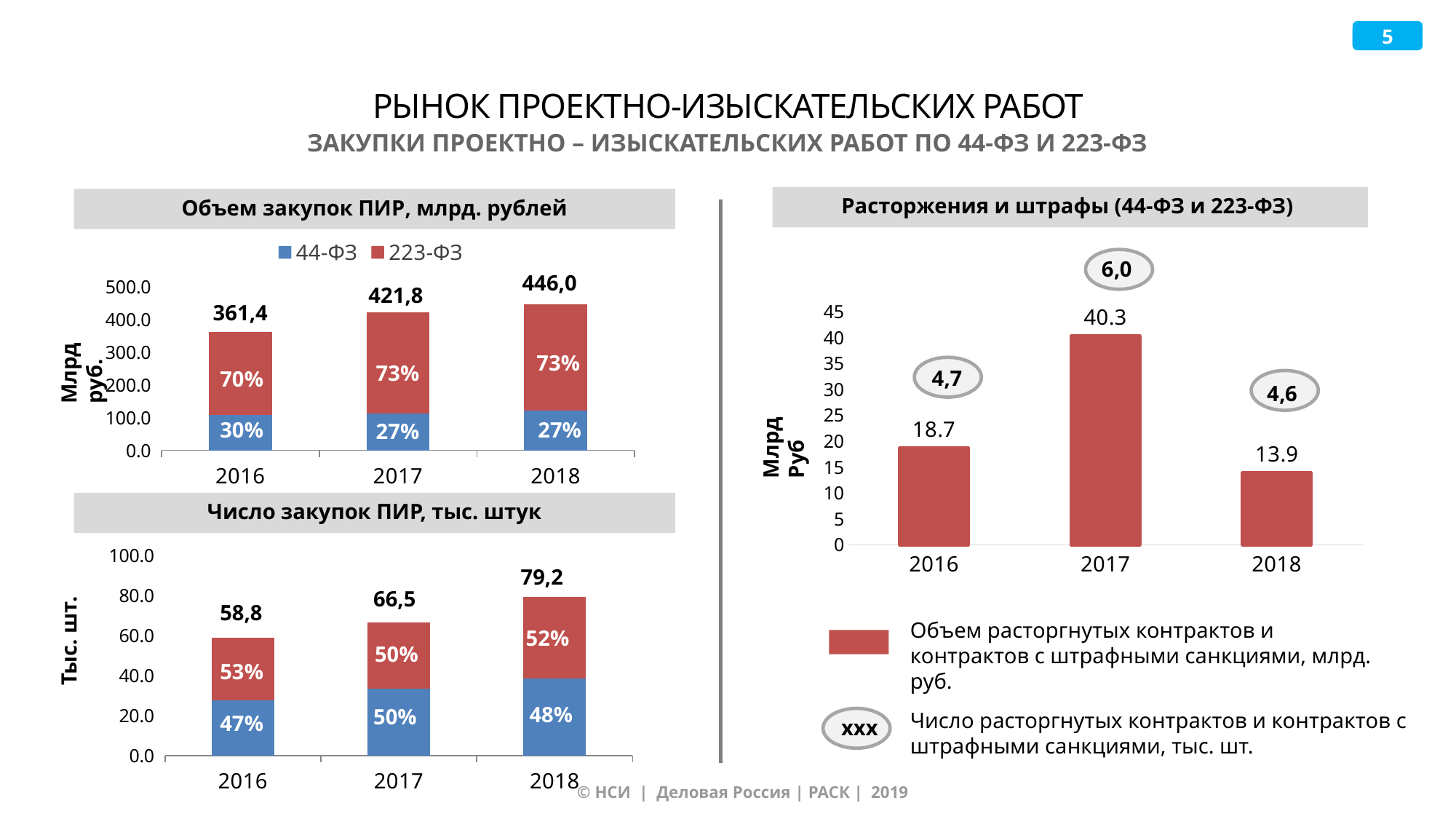
In the chart 'Расторжения и штрафы (44-ФЗ и 223-ФЗ)', which year has the lowest bar value? 2018 In the chart 'Число закупок ПИР, тыс. штук', what is the total value shown above the bar for 2017? 66,5 In the chart 'Объем закупок ПИР, млрд. рублей', what is the difference between the 2018 total and the 2016 total? 84,6 In the chart 'Расторжения и штрафы (44-ФЗ и 223-ФЗ)', what is the circled number shown above the 2016 bar? 4,7 In the chart 'Число закупок ПИР, тыс. штук', what share of the 2018 bar is labelled for 223-ФЗ? 52% In the chart 'Объем закупок ПИР, млрд. рублей', what share of the 2016 bar is labelled for 44-ФЗ? 30% In the chart 'Расторжения и штрафы (44-ФЗ и 223-ФЗ)', what is the value of the bar for 2017? 40.3 In the chart 'Объем закупок ПИР, млрд. рублей', do the total values rise or fall from 2016 to 2018? rise In the chart 'Число закупок ПИР, тыс. штук', how many years are shown on the x axis? 3 In the chart 'Объем закупок ПИР, млрд. рублей', how many series does the legend list? 2 In the chart 'Объем закупок ПИР, млрд. рублей', what is the total value shown above the bar for 2018? 446,0 In the chart 'Число закупок ПИР, тыс. штук', which year has the highest total? 2018